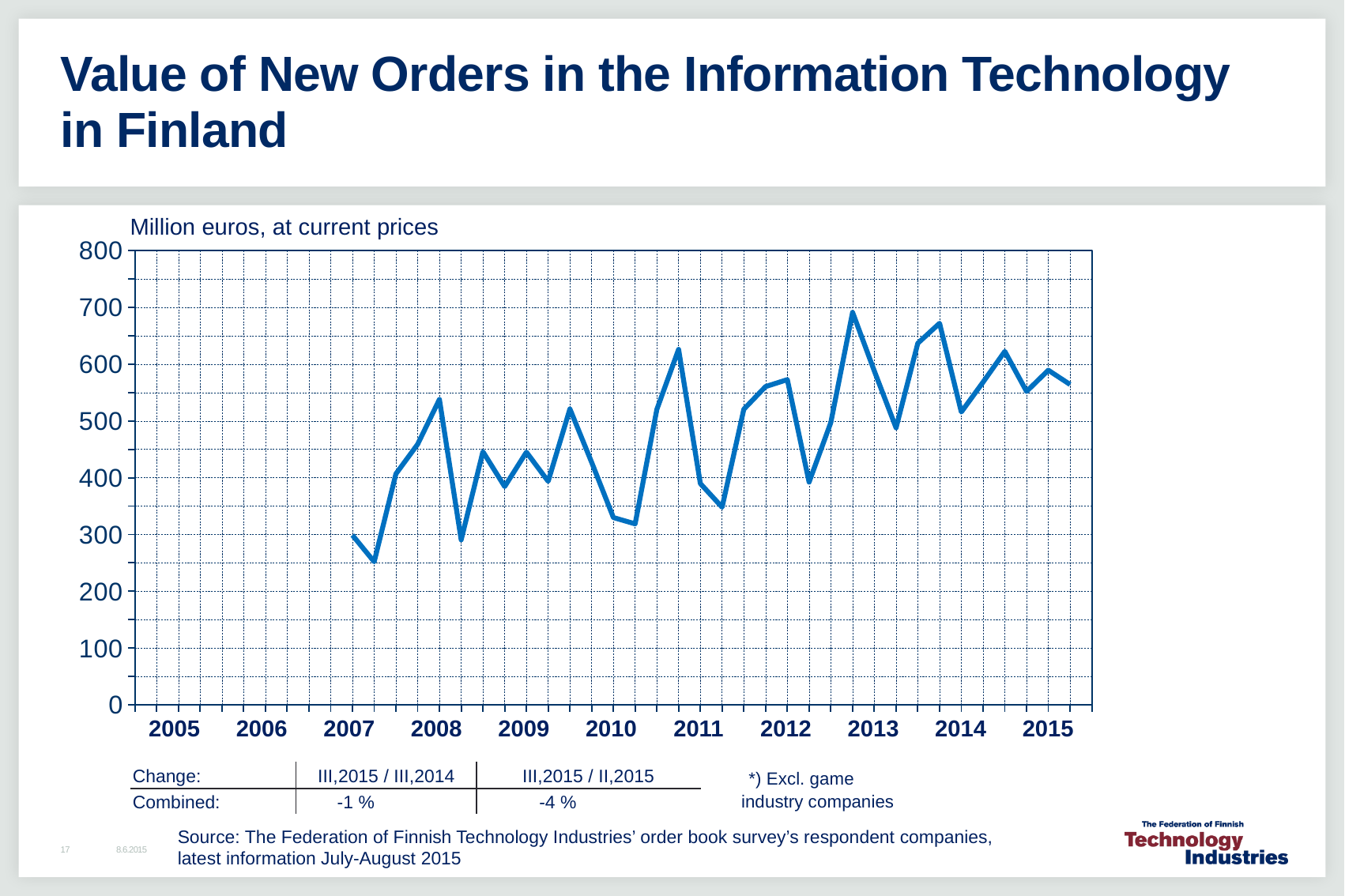
Is the value at the start of 2012 greater or less than 500? greater How many years are labelled on the horizontal axis? 11 What kind of chart is shown on the slide? line chart How many lines are plotted on the chart? 1 What is the highest value shown on the vertical axis? 800 Is the highest point of the line greater or less than 600? greater Overall, does the line rise or fall from 2007 to 2015? rise What is the combined change for III,2015 / II,2015 shown below the chart? -4 % Is the value at the start of 2015 greater or less than 500? greater What unit is given for the vertical axis of the chart? Million euros, at current prices